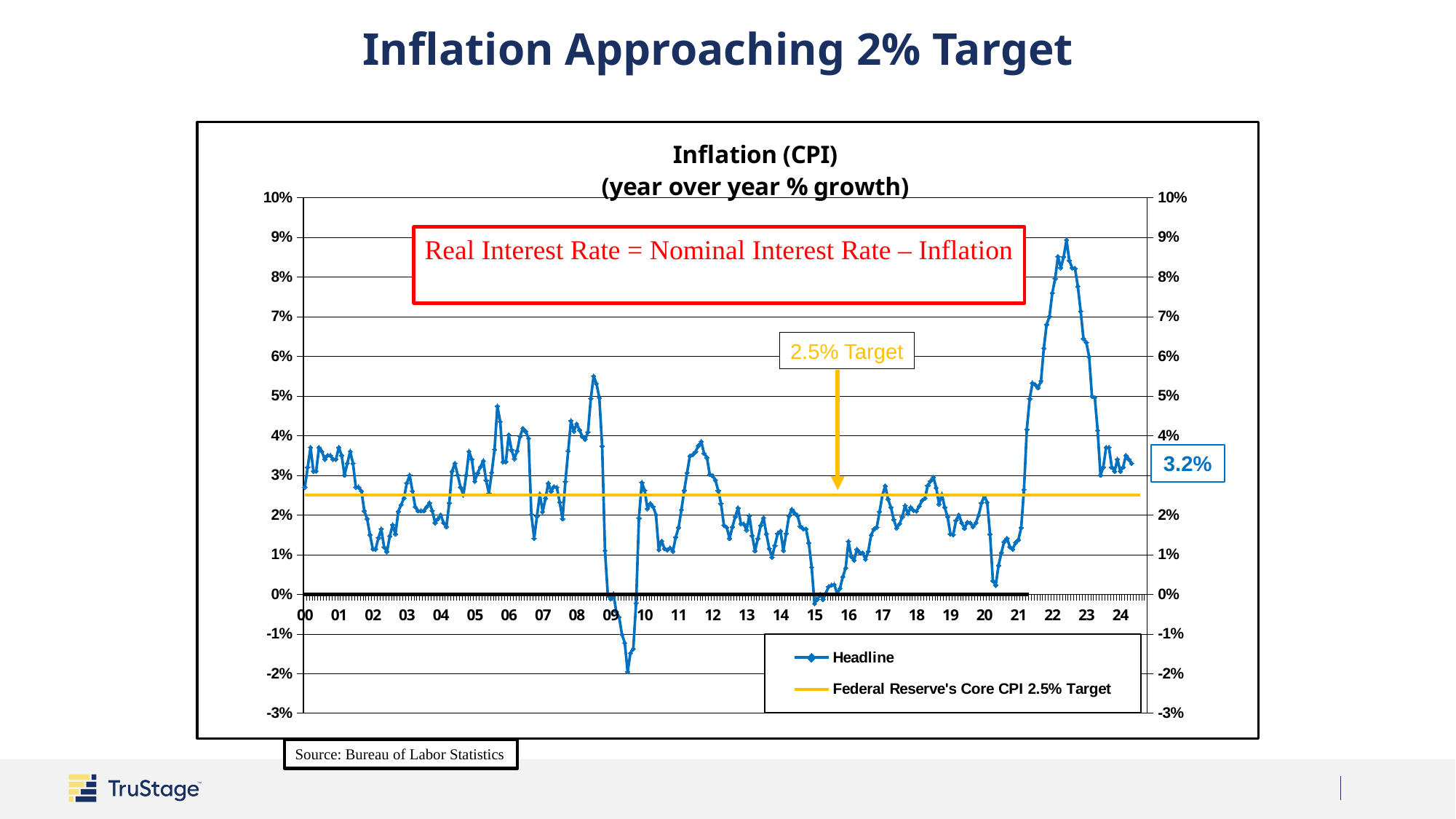
Which is higher: the Headline inflation peak in 2008 or the peak in 2022? 2022 Is the Headline inflation value in 2015 greater or less than 1%? less What kind of chart is shown on the slide? line chart Does Headline inflation rise or fall from its 2022 peak to 2024? fall What is the title of the chart? Inflation (CPI) (year over year % growth) In which year does the Headline inflation series reach its lowest value? 09 What is the most recent Headline inflation value labeled on the chart? 3.2% Is the lowest Headline inflation value in 2009 greater or less than -1%? less Is the peak Headline inflation value in 2022 greater or less than 8%? greater How many series does the legend list? 2 What value is the Federal Reserve's Core CPI target line drawn at? 2.5% In which year does the Headline inflation series reach its highest value? 22